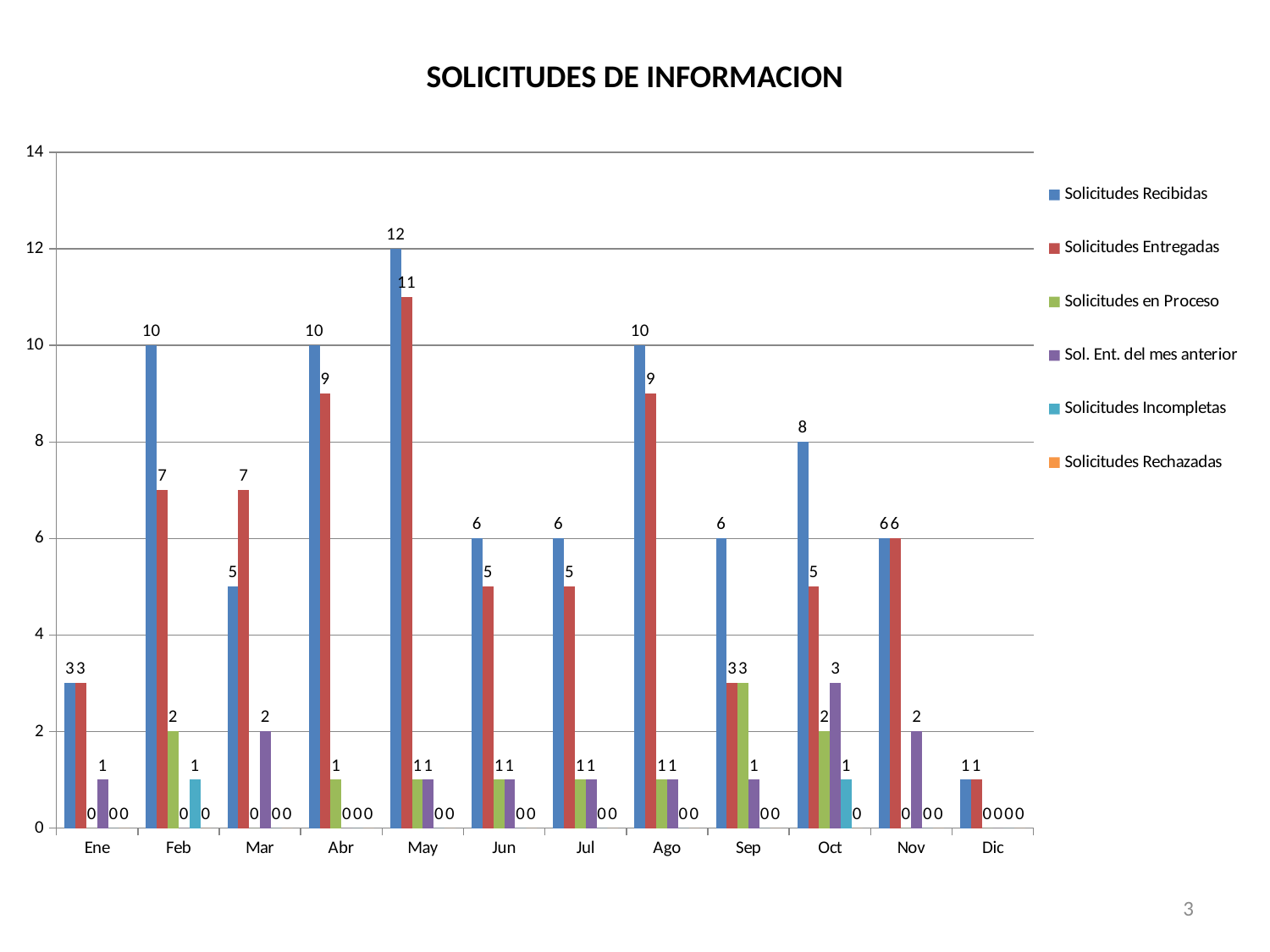
In which month is Solicitudes Recibidas lowest? Dic What is the value of Solicitudes Entregadas in Abr? 9 How many series does the legend list? 6 What is the value of Solicitudes Recibidas in May? 12 What is the value of Solicitudes en Proceso in Sep? 3 In Mar, which is larger: Solicitudes Recibidas or Solicitudes Entregadas? Solicitudes Entregadas What type of chart is shown on the slide? bar chart How many months are shown on the x axis? 12 What is the title of the chart? SOLICITUDES DE INFORMACION What is the difference between Solicitudes Recibidas and Solicitudes Entregadas in Feb? 3 What is the value of Sol. Ent. del mes anterior in Oct? 3 In which month is Solicitudes Recibidas highest? May